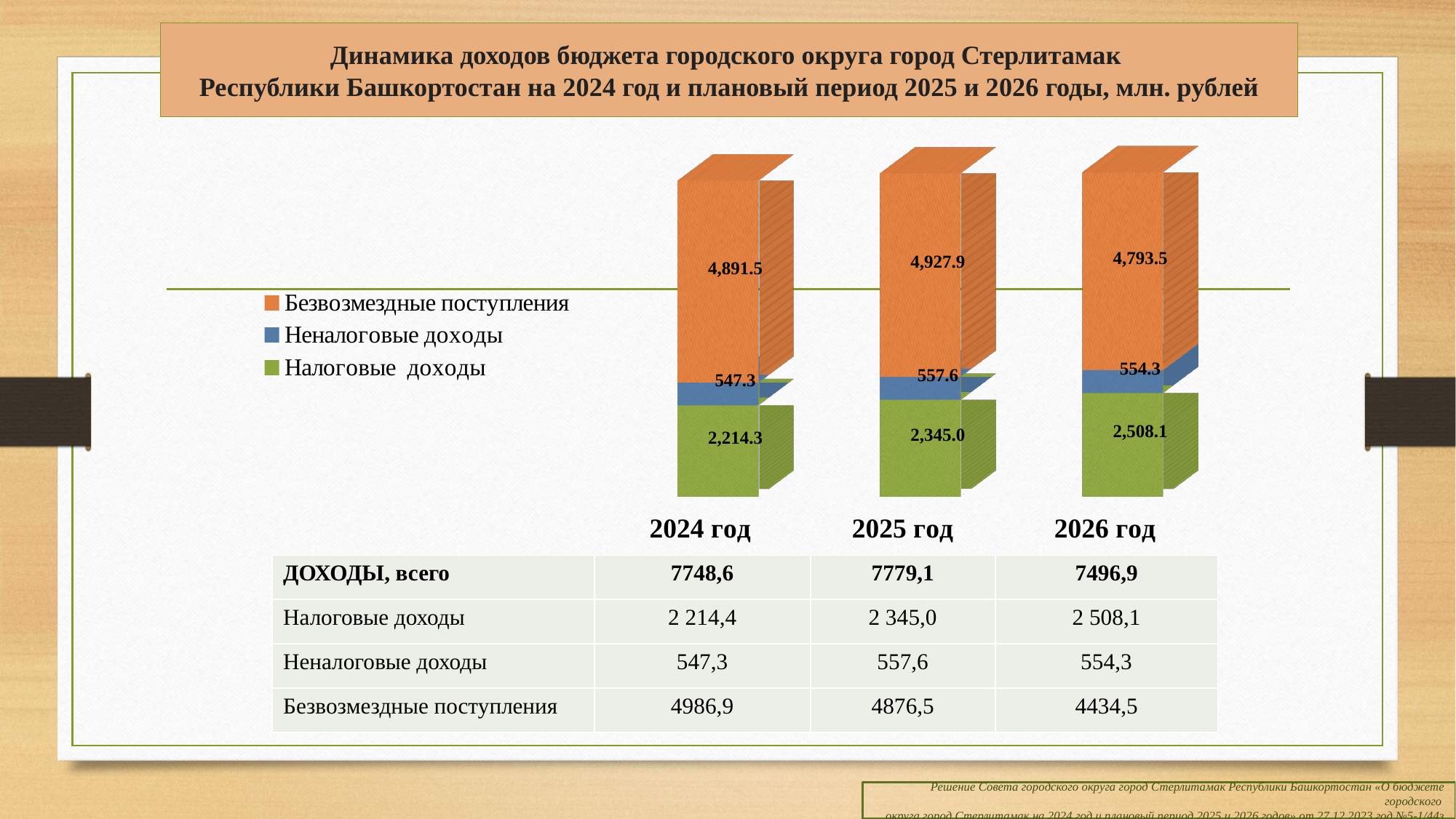
How many years (categories) are plotted on the chart? 3 What is the value of Безвозмездные поступления for 2025 год on the chart? 4,927.9 In which year is Налоговые доходы highest on the chart? 2026 год Do the values of Налоговые доходы rise or fall from 2024 год to 2026 год? Rise What is the value of Неналоговые доходы for 2026 год on the chart? 554.3 By how much does Налоговые доходы in 2026 год exceed Налоговые доходы in 2024 год on the chart? 293.8 What is the difference between Безвозмездные поступления in 2025 год and 2026 год on the chart? 134.4 How many series does the chart legend list? 3 In which year is Безвозмездные поступления lowest on the chart? 2026 год Which is larger on the chart: Неналоговые доходы in 2025 год or in 2026 год? 2025 год What kind of chart is shown on the slide? Stacked bar chart What is the value of Налоговые доходы for 2024 год on the chart? 2,214.3